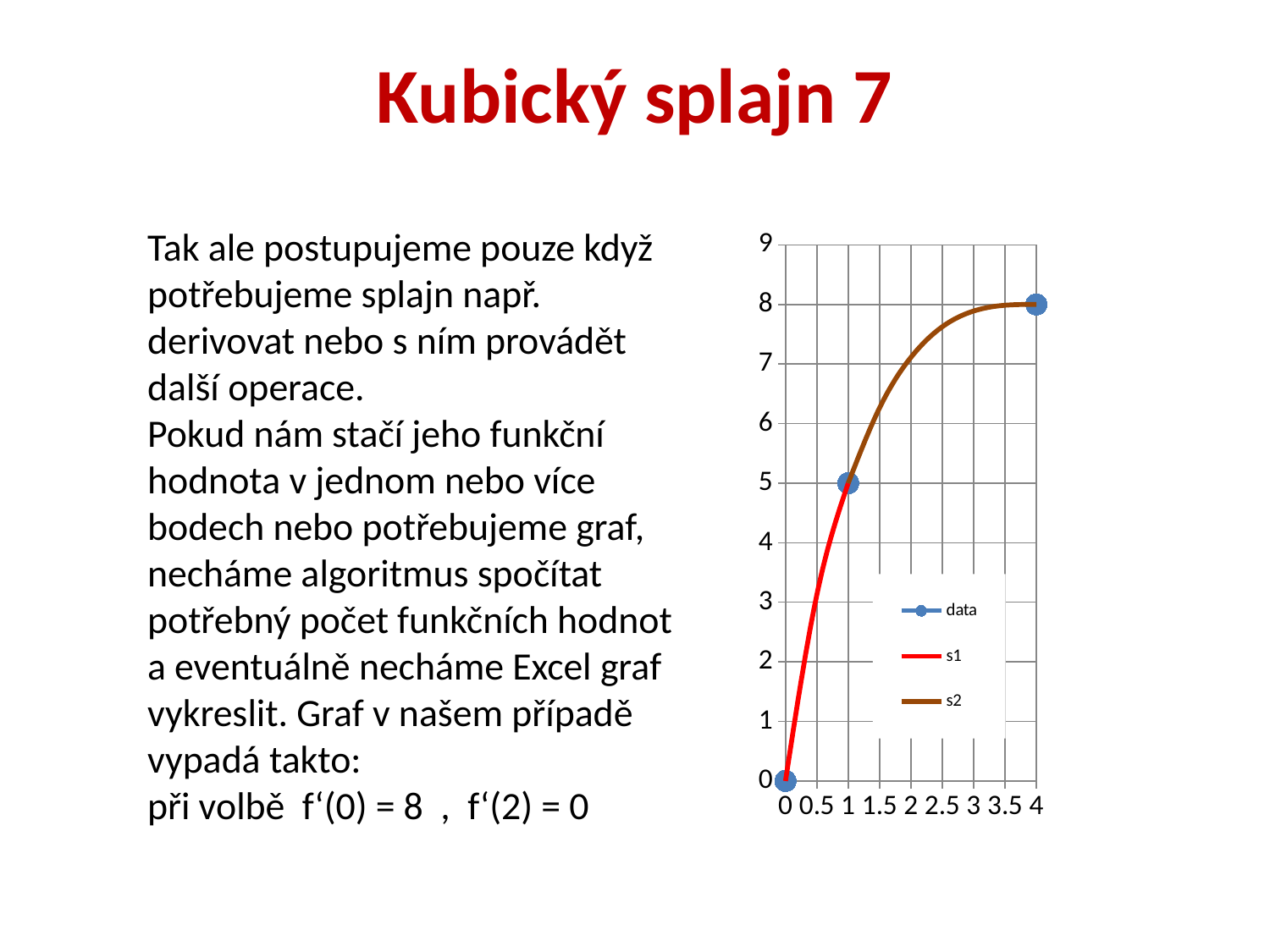
How many series does the chart legend list? 3 Is the value of the s2 curve at x = 2 greater or less than 6? greater What are the names of the series listed in the legend? data, s1, s2 What is the value of the 'data' series at x = 0? 0 Do the values of the curve rise or fall as x increases from 0 to 4? rise What is the value of the 'data' series at x = 1? 5 What is the value of the 'data' series at x = 4? 8 How many points does the 'data' series contain? 3 At which x value does the 'data' series have its lowest value? 0 What is the difference between the 'data' values at x = 4 and x = 1? 3 At which x value does the 'data' series reach its highest value? 4 What kind of chart is shown on the slide? line chart